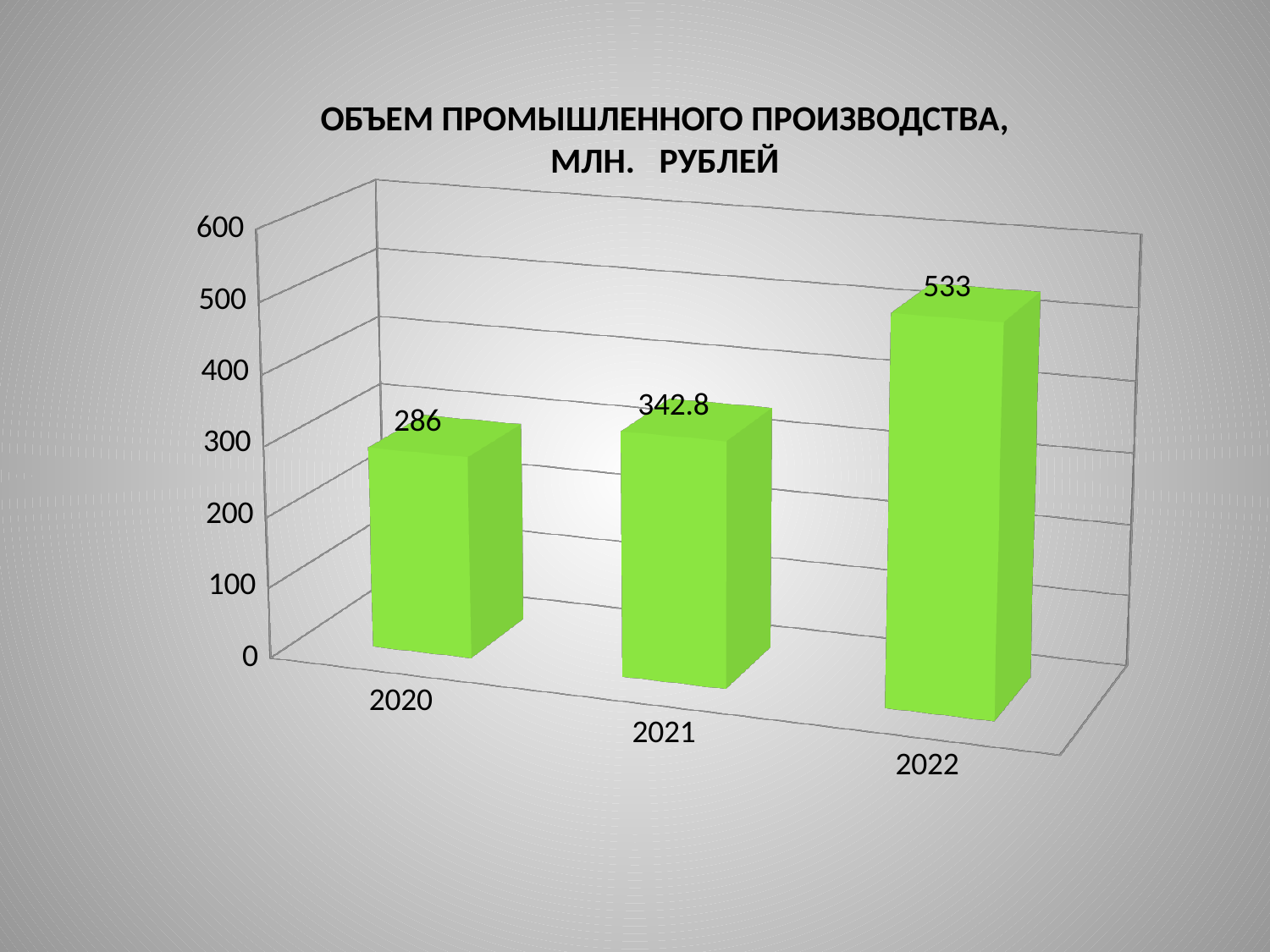
Is the value for 2022 greater or less than 500? greater What kind of chart is shown on the slide? bar chart Which year has the lowest value? 2020 Which is larger, the value for 2021 or the value for 2022? 2022 What is the difference between the values for 2021 and 2020? 56.8 What is the value for 2021? 342.8 How many years are shown on the chart? 3 What is the difference between the values for 2022 and 2020? 247 What is the value for 2022? 533 Do the values rise or fall from 2020 to 2022? rise What is the value for 2020? 286 Which year has the highest value? 2022